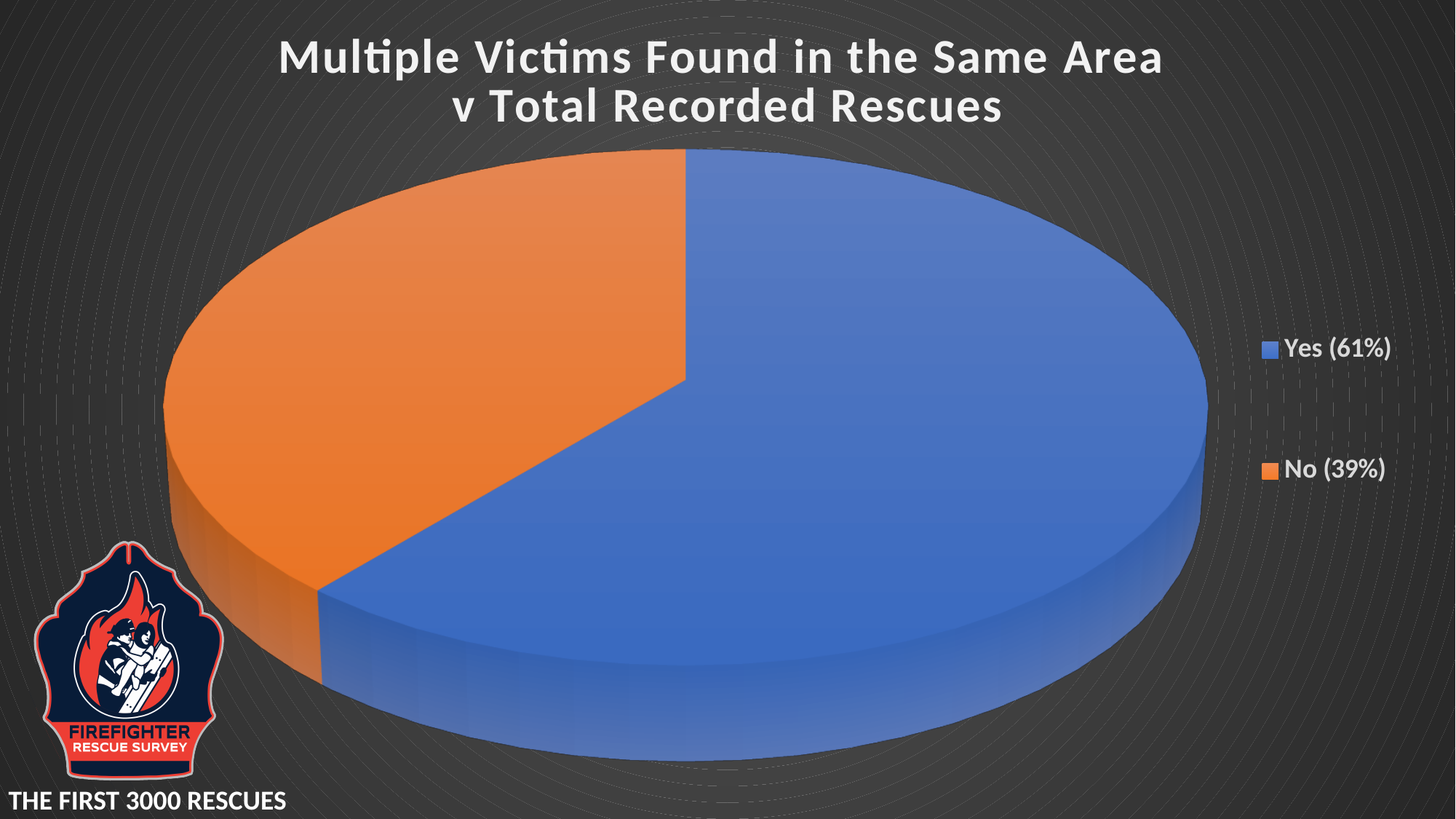
What colour is the "No" slice of the pie? orange How many entries does the legend list? 2 Which is larger, the "Yes" slice or the "No" slice? Yes How many categories are shown in the pie chart? 2 What is the difference in percentage points between the "Yes" and "No" slices? 22 What is the title of the chart? Multiple Victims Found in the Same Area v Total Recorded Rescues Which category has the largest slice of the pie? Yes What share of the pie does the "Yes" slice represent? 61% Which category has the smallest slice of the pie? No What share of the pie does the "No" slice represent? 39% What kind of chart is shown on the slide? pie chart